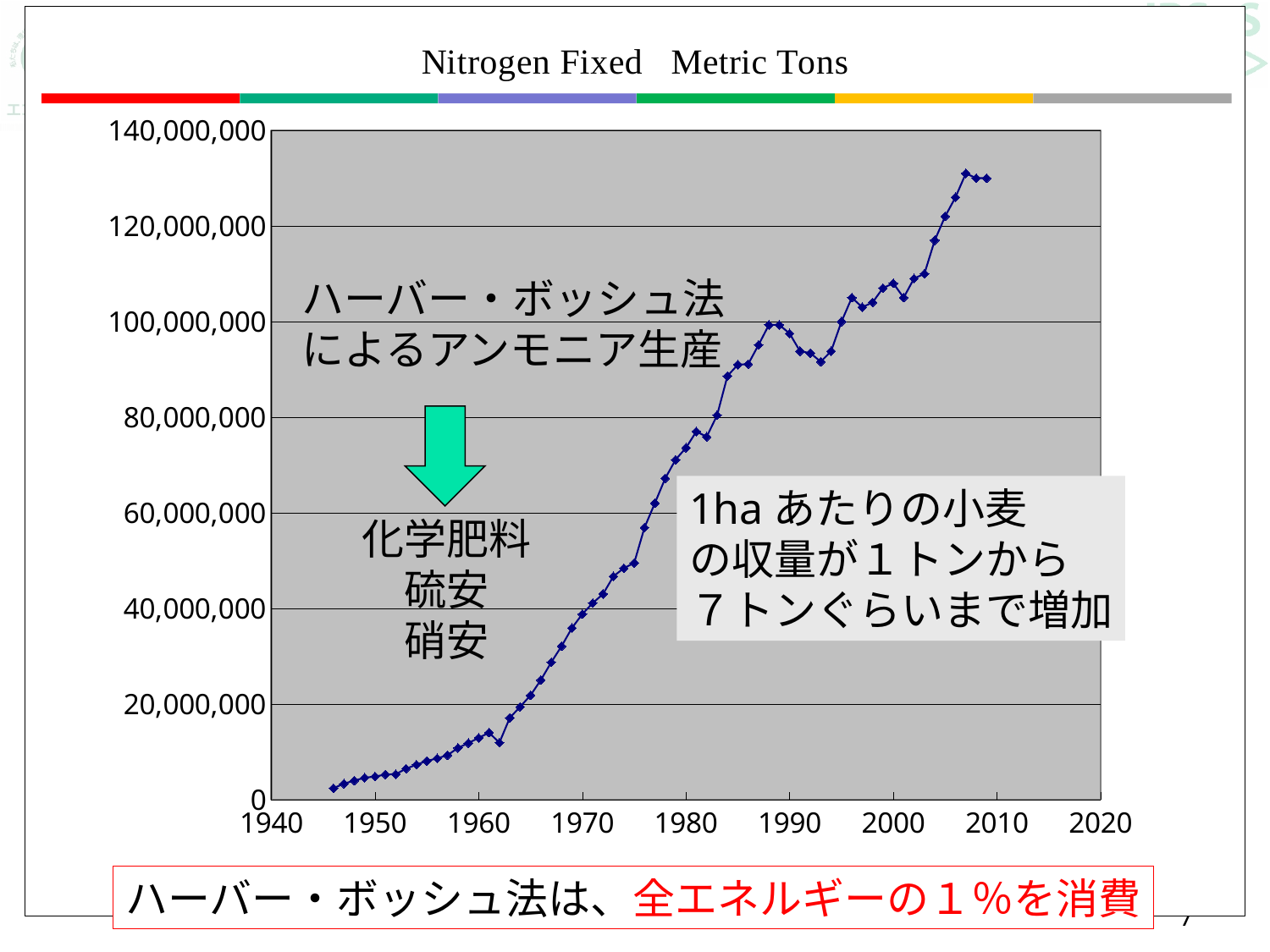
Overall, do the values on the chart rise or fall from 1946 to 2009? rise Is the value for 1960 greater or less than 20,000,000? less Which year has the larger value, 1980 or 2000? 2000 Does the highest point on the line occur before or after 2000? after Is the value for 1990 greater or less than 80,000,000? greater Which year has the larger value, 1960 or 1970? 1970 What is the highest value shown on the vertical axis? 140,000,000 What kind of chart is shown on the slide? line chart Is the value for 1980 greater or less than 60,000,000? greater What is the title of the chart? Nitrogen Fixed Metric Tons